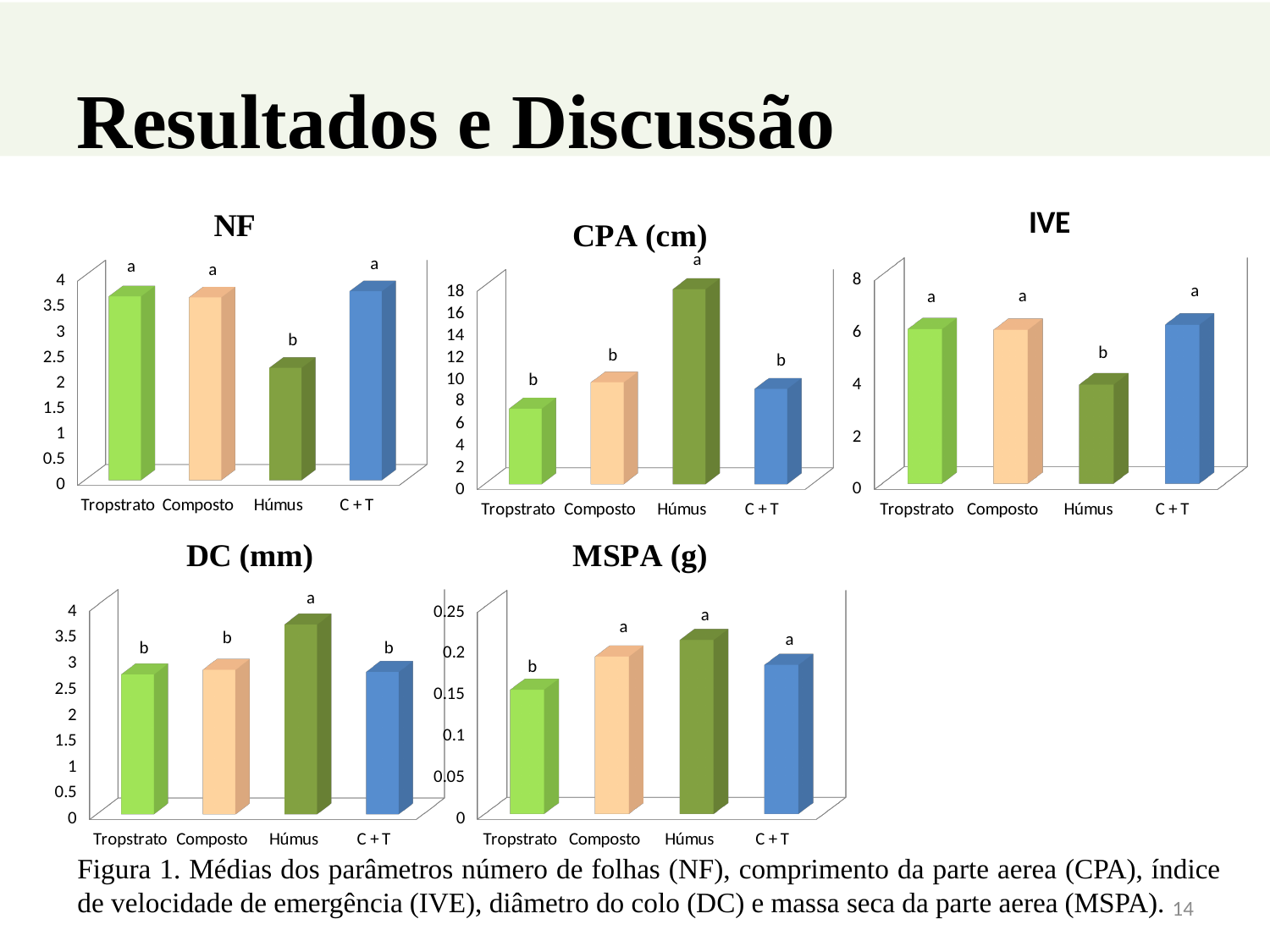
What kind of chart is the DC (mm) chart? bar chart In the DC (mm) chart, is the value for Húmus greater or less than 3? greater In the IVE chart, is the value for Húmus greater or less than 6? less In the MSPA (g) chart, which category has the lowest value? Tropstrato In the NF chart, which category has the lowest value? Húmus In the CPA (cm) chart, which category has the highest value? Húmus In the DC (mm) chart, which category has the highest value? Húmus In the MSPA (g) chart, is the value for Tropstrato greater or less than 0.2? less In the CPA (cm) chart, which category has the lowest value? Tropstrato How many categories are shown on the x axis of the NF chart? 4